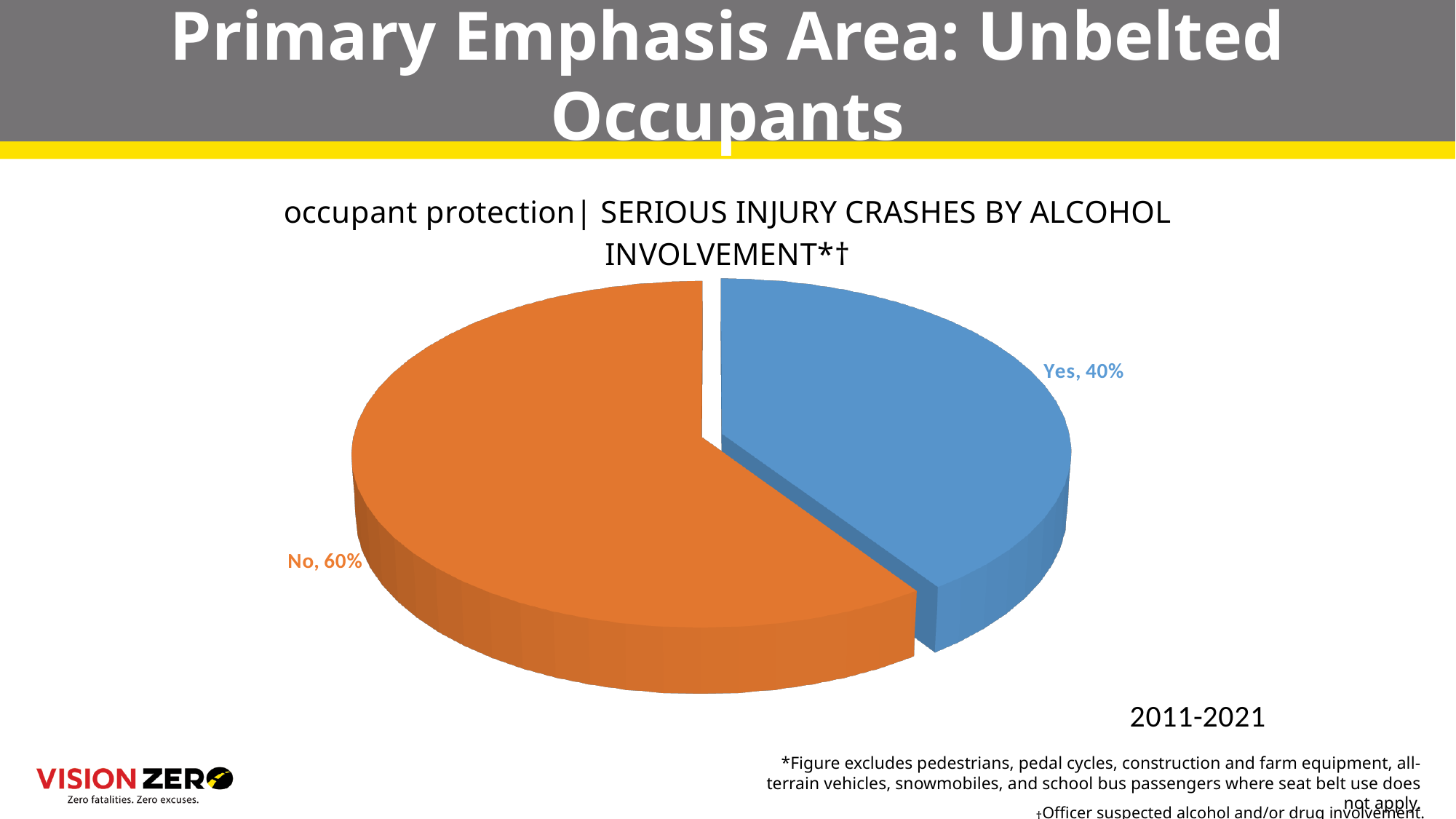
What is the difference in percentage points between the No slice and the Yes slice? 20% What colour is the No slice of the pie? orange What share of serious injury crashes involved alcohol (Yes)? 40% Which slice of the pie is the largest? No What share of serious injury crashes did not involve alcohol (No)? 60% What kind of chart is shown on the slide? pie chart What time period does the chart cover? 2011-2021 Which slice of the pie is the smallest? Yes Which is larger, the Yes slice or the No slice? No How many slices does the pie chart have? 2 What is the title of the chart? occupant protection| SERIOUS INJURY CRASHES BY ALCOHOL INVOLVEMENT*†